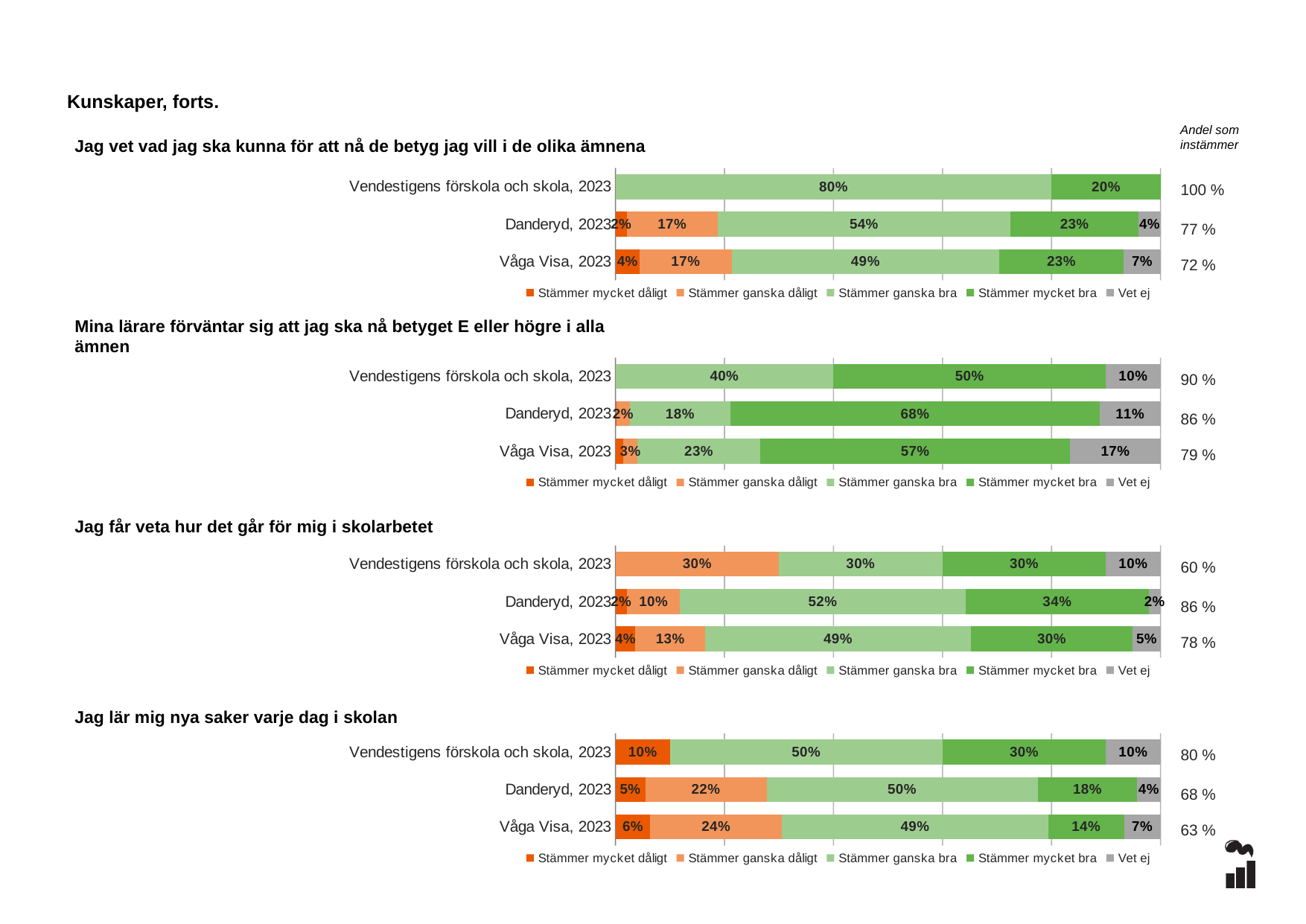
In the chart 'Jag lär mig nya saker varje dag i skolan', is the 'Stämmer ganska dåligt' value larger for Danderyd, 2023 or Våga Visa, 2023? Våga Visa, 2023 How many series does the legend list in the chart 'Jag vet vad jag ska kunna för att nå de betyg jag vill i de olika ämnena'? 5 In the chart 'Jag vet vad jag ska kunna för att nå de betyg jag vill i de olika ämnena', what is the 'Vet ej' value for Våga Visa, 2023? 7% In the chart 'Jag får veta hur det går för mig i skolarbetet', what is the 'Stämmer ganska dåligt' value for Vendestigens förskola och skola, 2023? 30% What kind of chart is 'Mina lärare förväntar sig att jag ska nå betyget E eller högre i alla ämnen'? Stacked bar chart How many categories are shown in the chart 'Jag får veta hur det går för mig i skolarbetet'? 3 In the chart 'Jag får veta hur det går för mig i skolarbetet', what is the difference between the 'Stämmer ganska bra' values for Danderyd, 2023 and Våga Visa, 2023? 3% In the chart 'Jag vet vad jag ska kunna för att nå de betyg jag vill i de olika ämnena', what is the 'Stämmer ganska bra' value for Vendestigens förskola och skola, 2023? 80% In the chart 'Jag lär mig nya saker varje dag i skolan', which category has the lowest 'Stämmer mycket bra' value? Våga Visa, 2023 In the chart 'Mina lärare förväntar sig att jag ska nå betyget E eller högre i alla ämnen', what is the 'Stämmer mycket bra' value for Danderyd, 2023? 68% In the chart 'Mina lärare förväntar sig att jag ska nå betyget E eller högre i alla ämnen', which category has the highest 'Stämmer mycket bra' value? Danderyd, 2023 In the chart 'Jag lär mig nya saker varje dag i skolan', what is the 'Stämmer mycket dåligt' value for Vendestigens förskola och skola, 2023? 10%